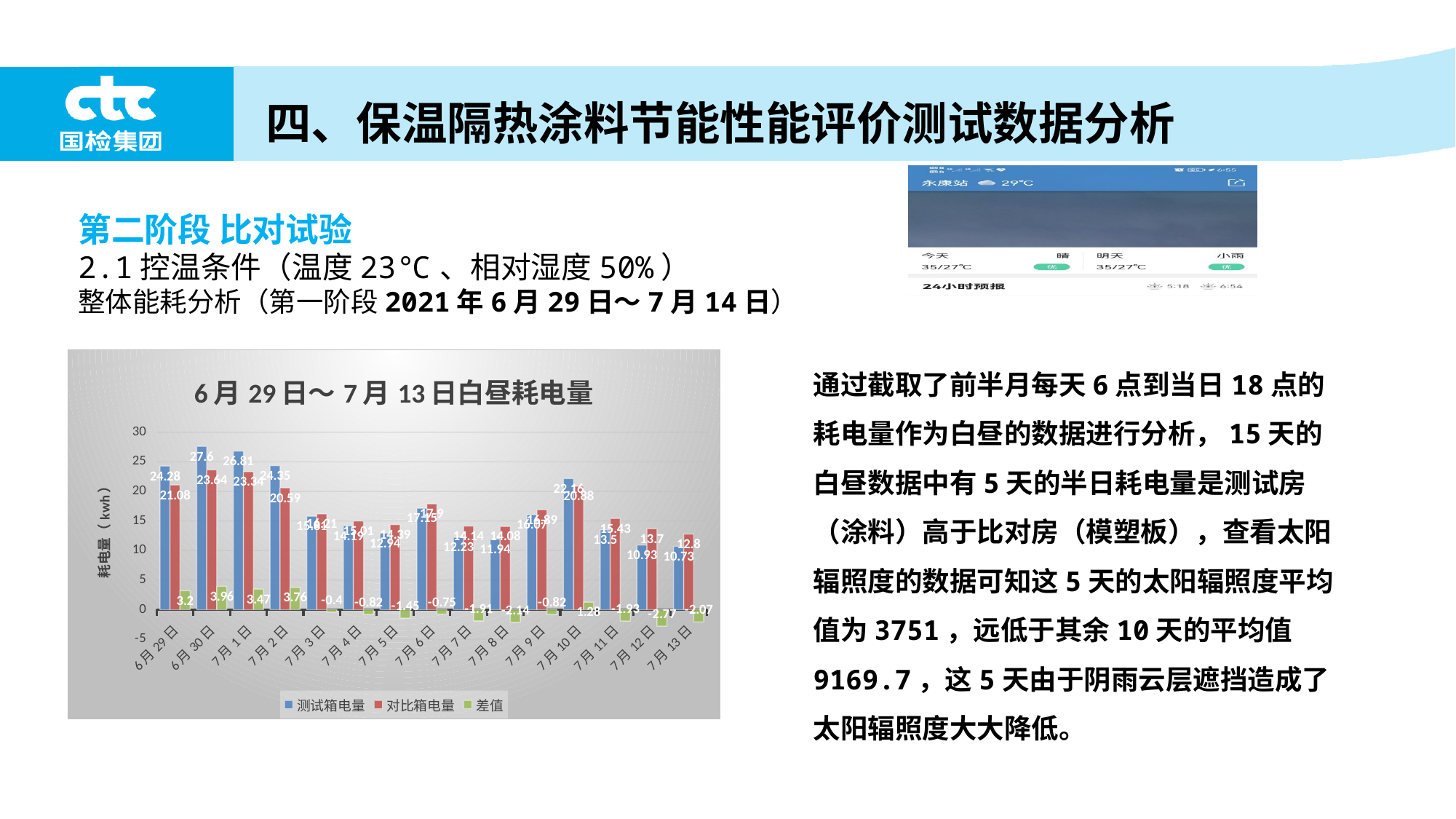
How many series does the chart legend list? 3 What is the 对比箱电量 value for 7月12日? 13.7 What type of chart is shown on the slide? bar chart What is the title of the chart? 6月29日～7月13日白昼耗电量 Is the 测试箱电量 value for 7月1日 greater or less than 25? greater What is the difference between 测试箱电量 and 对比箱电量 on 7月10日? 1.28 Which is larger on 7月8日, 测试箱电量 or 对比箱电量? 对比箱电量 How many dates (categories) are shown on the x axis of the chart? 15 What is the 测试箱电量 value for 6月30日? 27.6 On which date is the 差值 value lowest? 7月12日 On which date is the 测试箱电量 value highest? 6月30日 What is the 差值 value for 7月2日? 3.76